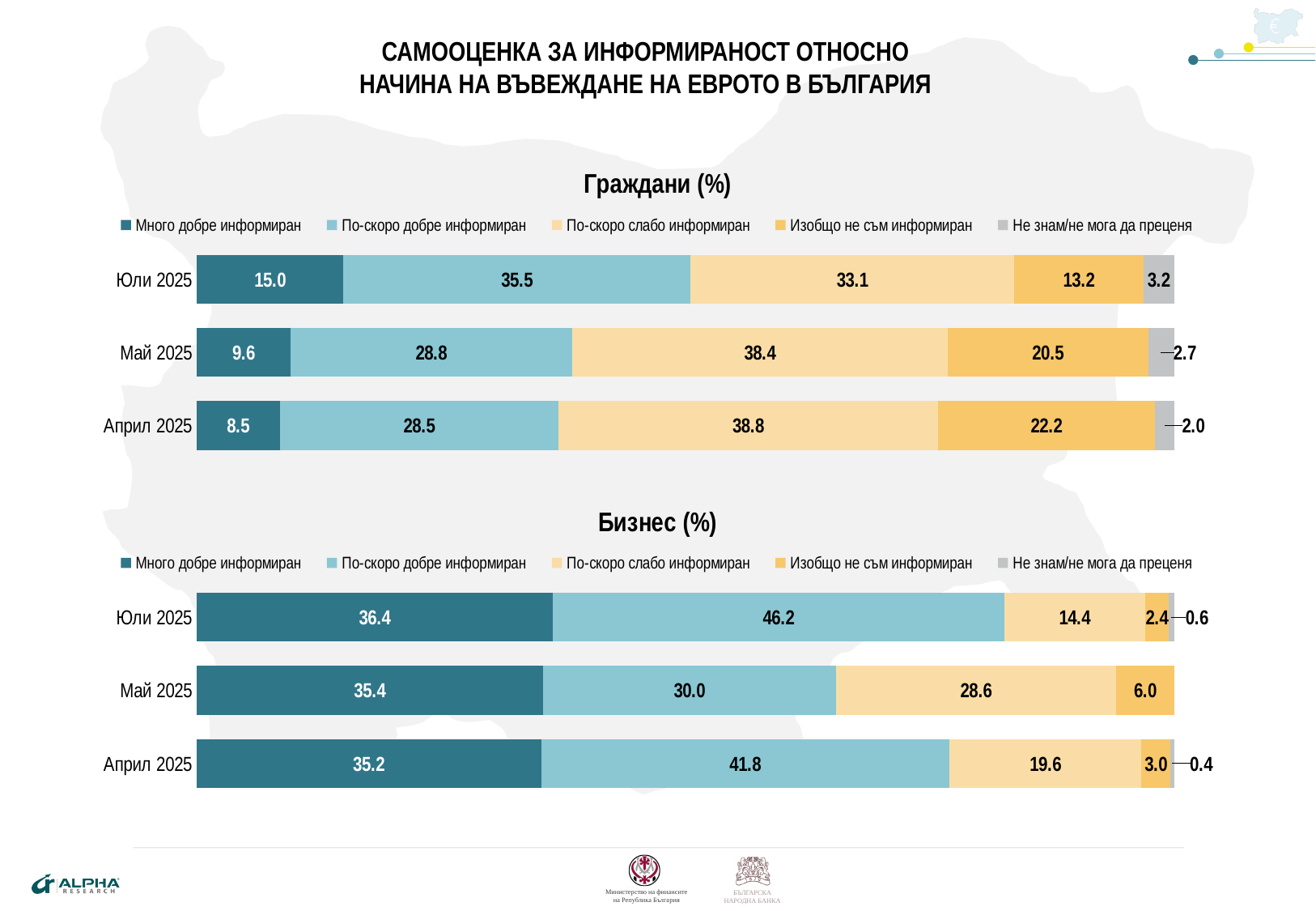
In the Бизнес (%) chart, what is the value for По-скоро добре информиран in Юли 2025? 46.2 In the Граждани (%) chart, what is the value for По-скоро слабо информиран in Април 2025? 38.8 In the Граждани (%) chart, what is the difference between the Много добре информиран values for Юли 2025 and Май 2025? 5.4 How many periods are shown in the Бизнес (%) chart? 3 How many series does the legend of the Граждани (%) chart list? 5 In the Бизнес (%) chart, which is larger: По-скоро слабо информиран in Май 2025 or in Април 2025? Май 2025 In the Бизнес (%) chart, which period has the lowest value for По-скоро добре информиран? Май 2025 In the Граждани (%) chart, what is the value for Много добре информиран in Юли 2025? 15.0 In the Граждани (%) chart, which period has the highest value for Изобщо не съм информиран? Април 2025 In the Бизнес (%) chart, what is the value for Изобщо не съм информиран in Май 2025? 6.0 What kind of chart is the Граждани (%) chart? Stacked bar chart In the Граждани (%) chart, does the value for Много добре информиран rise or fall from Април 2025 to Юли 2025? Rise